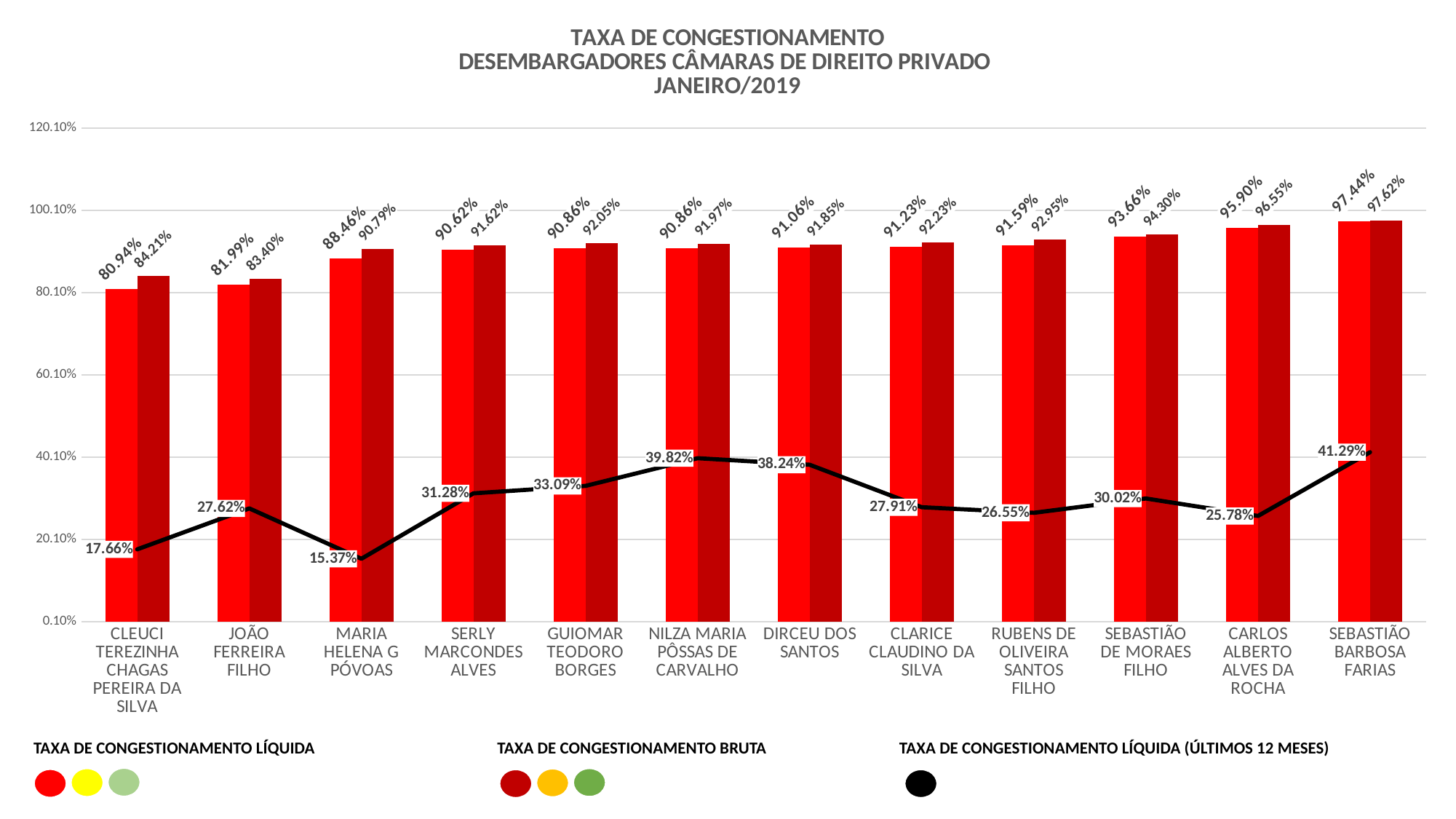
What kind of chart is shown on the slide? Bar chart with a line Do the TAXA DE CONGESTIONAMENTO LÍQUIDA bars rise or fall from left to right along the x axis? Rise Is the TAXA DE CONGESTIONAMENTO LÍQUIDA value for JOÃO FERREIRA FILHO greater or less than 80.10%? greater What is the TAXA DE CONGESTIONAMENTO LÍQUIDA (ÚLTIMOS 12 MESES) value for NILZA MARIA PÔSSAS DE CARVALHO? 39.82% How many series does the legend list? 3 How many desembargadores are shown on the x axis? 12 Which desembargador has the lowest TAXA DE CONGESTIONAMENTO LÍQUIDA (ÚLTIMOS 12 MESES)? MARIA HELENA G PÓVOAS What is the difference between the TAXA DE CONGESTIONAMENTO BRUTA and the TAXA DE CONGESTIONAMENTO LÍQUIDA for CLEUCI TEREZINHA CHAGAS PEREIRA DA SILVA? 3.27% What is the TAXA DE CONGESTIONAMENTO LÍQUIDA value for SERLY MARCONDES ALVES? 90.62% Which desembargador has the highest TAXA DE CONGESTIONAMENTO BRUTA? SEBASTIÃO BARBOSA FARIAS Which is larger: the TAXA DE CONGESTIONAMENTO LÍQUIDA (ÚLTIMOS 12 MESES) for DIRCEU DOS SANTOS or for CLARICE CLAUDINO DA SILVA? DIRCEU DOS SANTOS What is the TAXA DE CONGESTIONAMENTO BRUTA value for RUBENS DE OLIVEIRA SANTOS FILHO? 92.95%